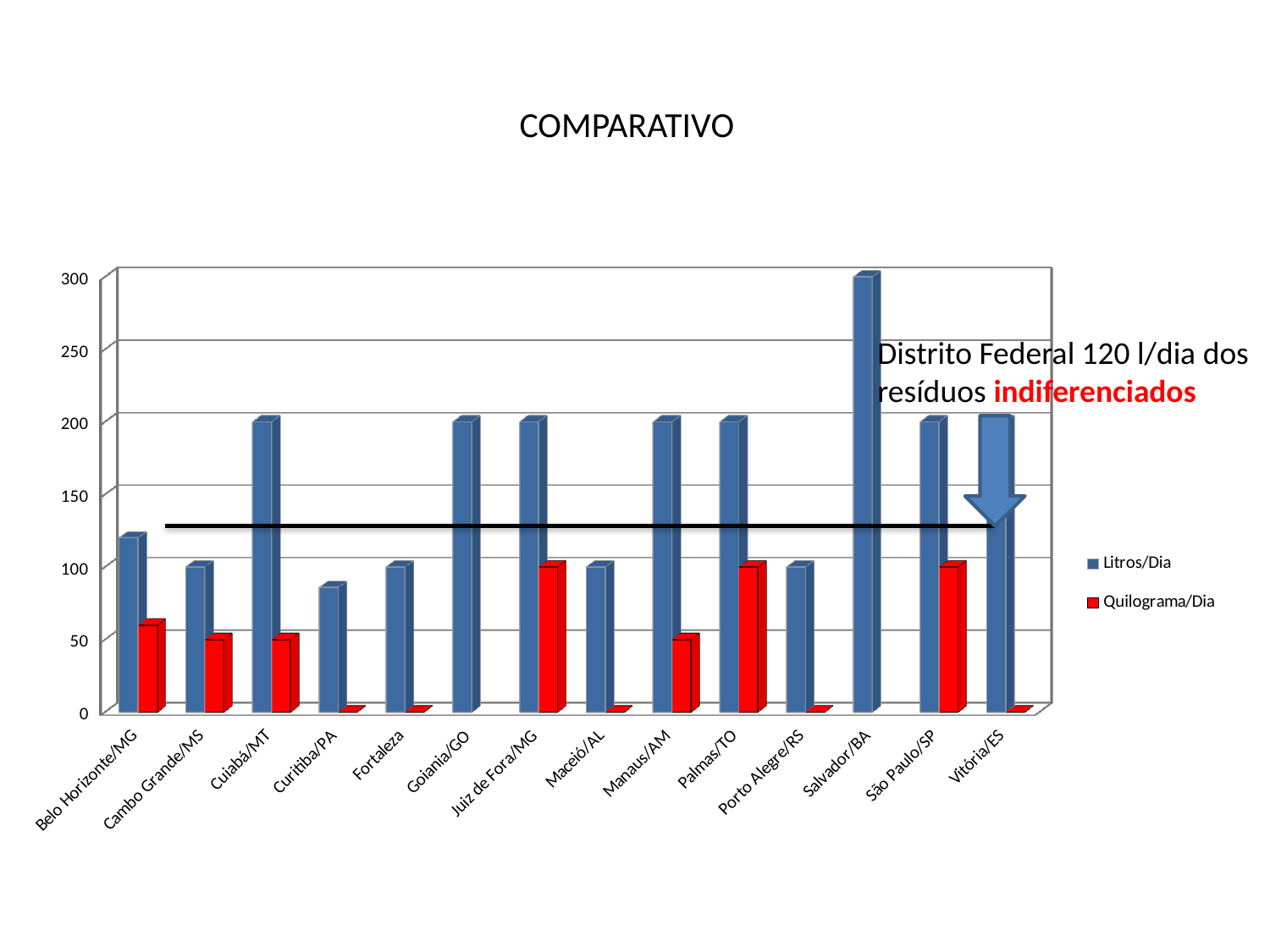
How many series does the legend list? 2 Is the Quilograma/Dia value for Juiz de Fora/MG greater or less than 50? greater What is the title of the chart? COMPARATIVO Which city has the lowest Litros/Dia value? Curitiba/PA Which is larger, the Litros/Dia value for Belo Horizonte/MG or for Cambo Grande/MS? Belo Horizonte/MG Which colour represents the Quilograma/Dia series in the chart? red Which city has the highest Litros/Dia value? Salvador/BA How many cities are shown on the x axis of the chart? 14 What is the Litros/Dia value for Salvador/BA? 300 What kind of chart is shown on the slide? bar chart Is the Litros/Dia value for Curitiba/PA greater or less than 100? less Is the Litros/Dia value for Belo Horizonte/MG greater or less than 100? greater